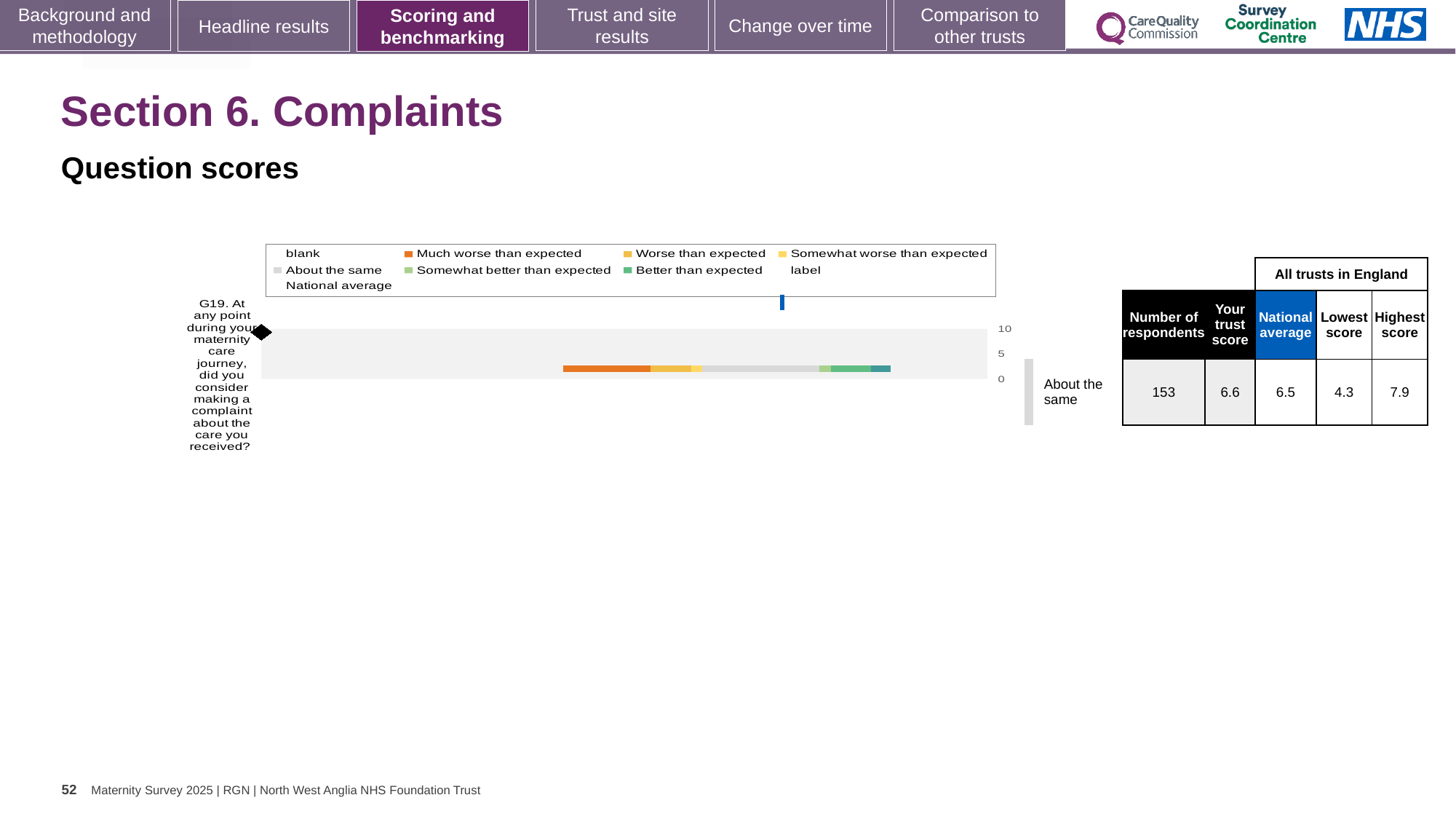
Which is larger for question G19: the trust score or the national average? the trust score What kind of chart is used to show the G19 question score? bar chart What is the lowest score among all trusts in England for question G19? 4.3 How many questions are plotted on the chart? 1 What is the national average score for question G19? 6.5 Which legend entry is shown in orange on the chart? Much worse than expected What does the blue vertical line on the chart represent, according to the legend? National average What is the highest score among all trusts in England for question G19? 7.9 Which benchmark category is the trust's G19 score placed in? About the same What is the trust score for question G19 about considering making a complaint? 6.6 What is the difference between the highest and lowest scores for question G19? 3.6 How many respondents answered question G19? 153